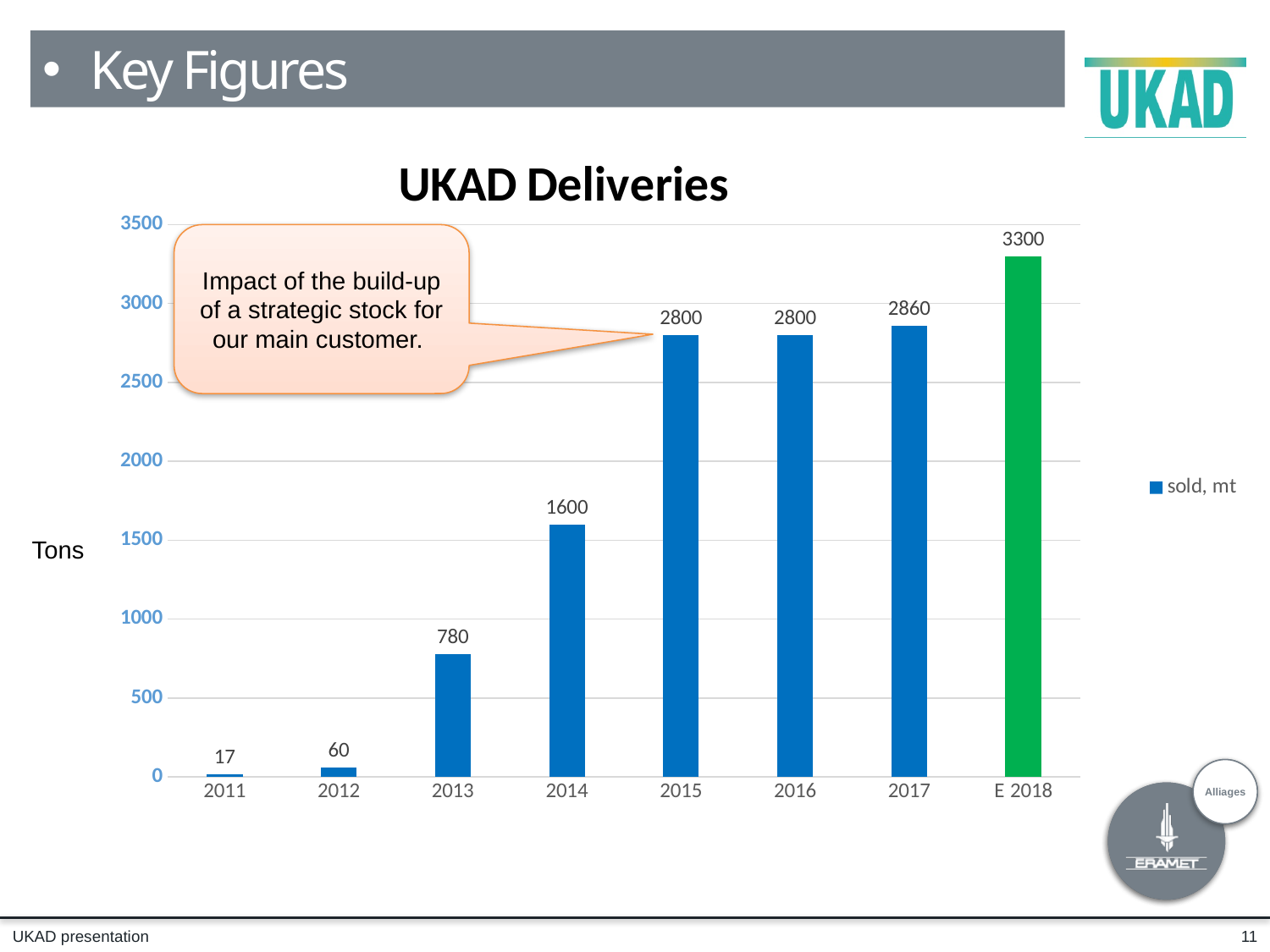
Which category has the highest value in the UKAD Deliveries chart? E 2018 Which is larger in the UKAD Deliveries chart, the value for 2017 or the value for 2016? 2017 What is the difference between the values for 2014 and 2013 in the UKAD Deliveries chart? 820 What is the value for E 2018 in the UKAD Deliveries chart? 3300 What is the legend entry in the UKAD Deliveries chart? sold, mt What is the value for 2014 in the UKAD Deliveries chart? 1600 How many series does the legend of the UKAD Deliveries chart list? 1 How many categories are shown on the x axis of the UKAD Deliveries chart? 8 What kind of chart is the UKAD Deliveries chart? bar chart Do the values in the UKAD Deliveries chart generally rise or fall from 2011 to E 2018? rise Which year has the lowest value in the UKAD Deliveries chart? 2011 What is the value for 2017 in the UKAD Deliveries chart? 2860